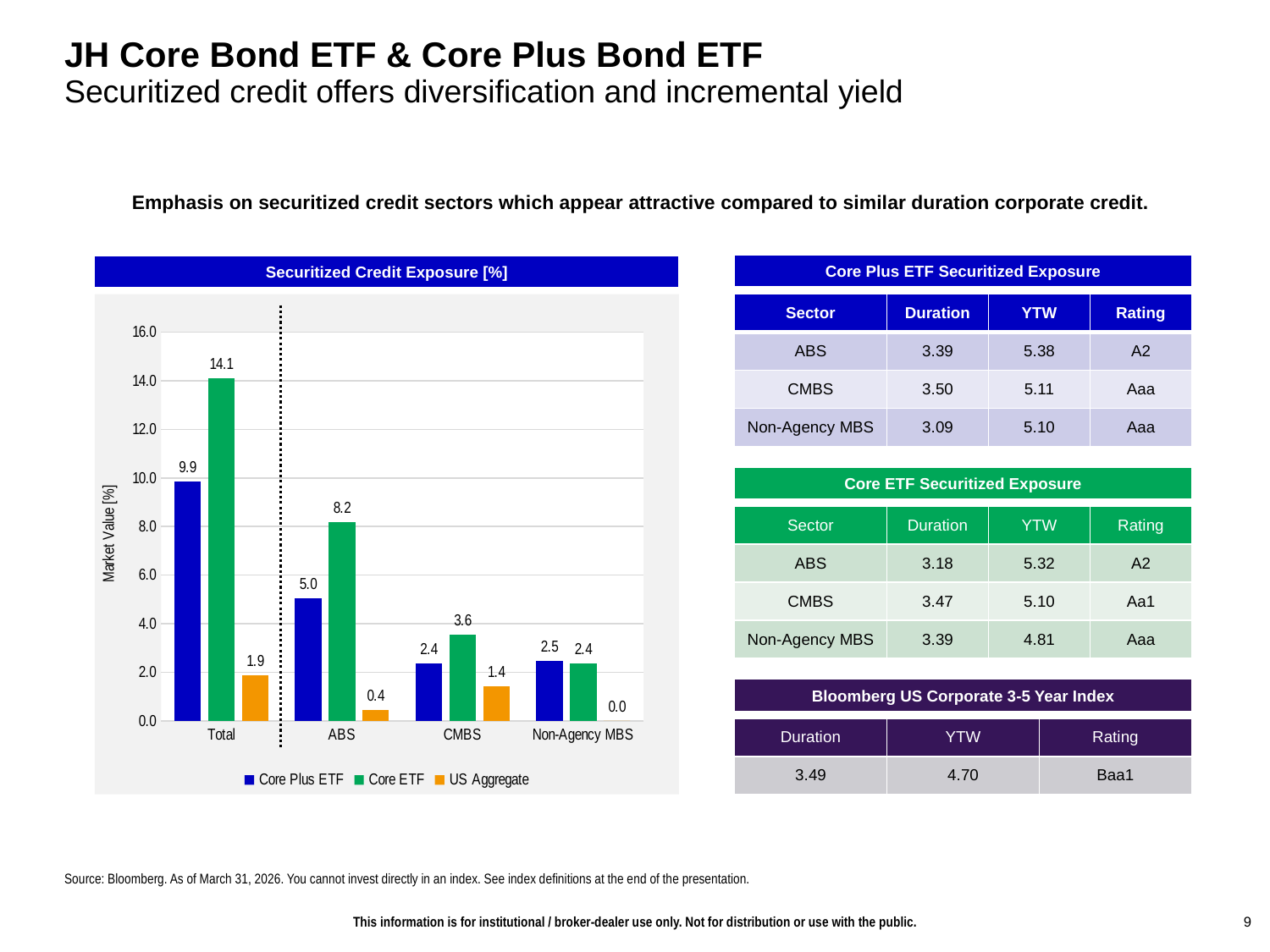
What is the Core Plus ETF value for ABS in the Securitized Credit Exposure chart? 5.0 What is the difference between the Core ETF and US Aggregate values for ABS in the Securitized Credit Exposure chart? 7.8 How many categories are shown on the x axis of the Securitized Credit Exposure chart? 4 In the Securitized Credit Exposure chart, is the Core ETF value for CMBS larger than the Core Plus ETF value for CMBS? Yes What is the US Aggregate value for Non-Agency MBS in the Securitized Credit Exposure chart? 0.0 Which category has the lowest US Aggregate value in the Securitized Credit Exposure chart? Non-Agency MBS What is the US Aggregate value for CMBS in the Securitized Credit Exposure chart? 1.4 Which category has the highest Core Plus ETF value in the Securitized Credit Exposure chart? Total How many series does the legend of the Securitized Credit Exposure chart list? 3 What is the difference between the Core ETF and Core Plus ETF values for Total in the Securitized Credit Exposure chart? 4.2 What kind of chart is the Securitized Credit Exposure chart? Bar chart What is the Core ETF value for Total in the Securitized Credit Exposure chart? 14.1